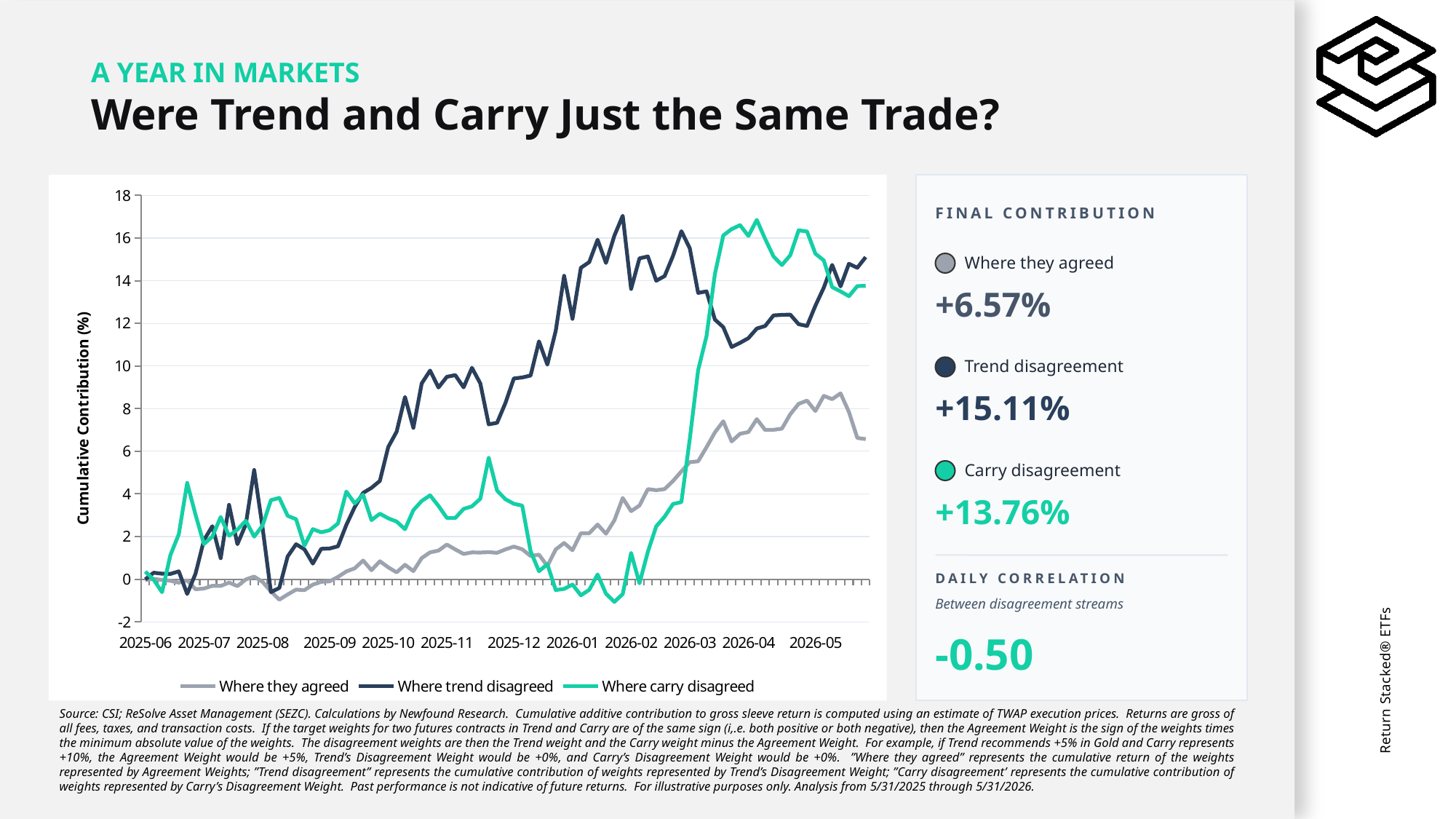
Does the 'Where they agreed' line generally rise or fall from 2025-06 to 2026-05? rise What is the final contribution for 'Where they agreed'? +6.57% Is the value for 'Where trend disagreed' at 2025-11 greater or less than 8? greater What kind of chart is shown on the slide? line chart What is the label of the chart's y axis? Cumulative Contribution (%) What is the difference between the final contributions of Trend disagreement and Carry disagreement? 1.35% Which series has the highest final contribution? Trend disagreement What is the final contribution for 'Carry disagreement'? +13.76% Which series has the lowest final contribution? Where they agreed Is the value for 'Where carry disagreed' at 2026-01 greater or less than 2? less What is the final contribution for 'Trend disagreement'? +15.11% How many series does the chart's legend list? 3